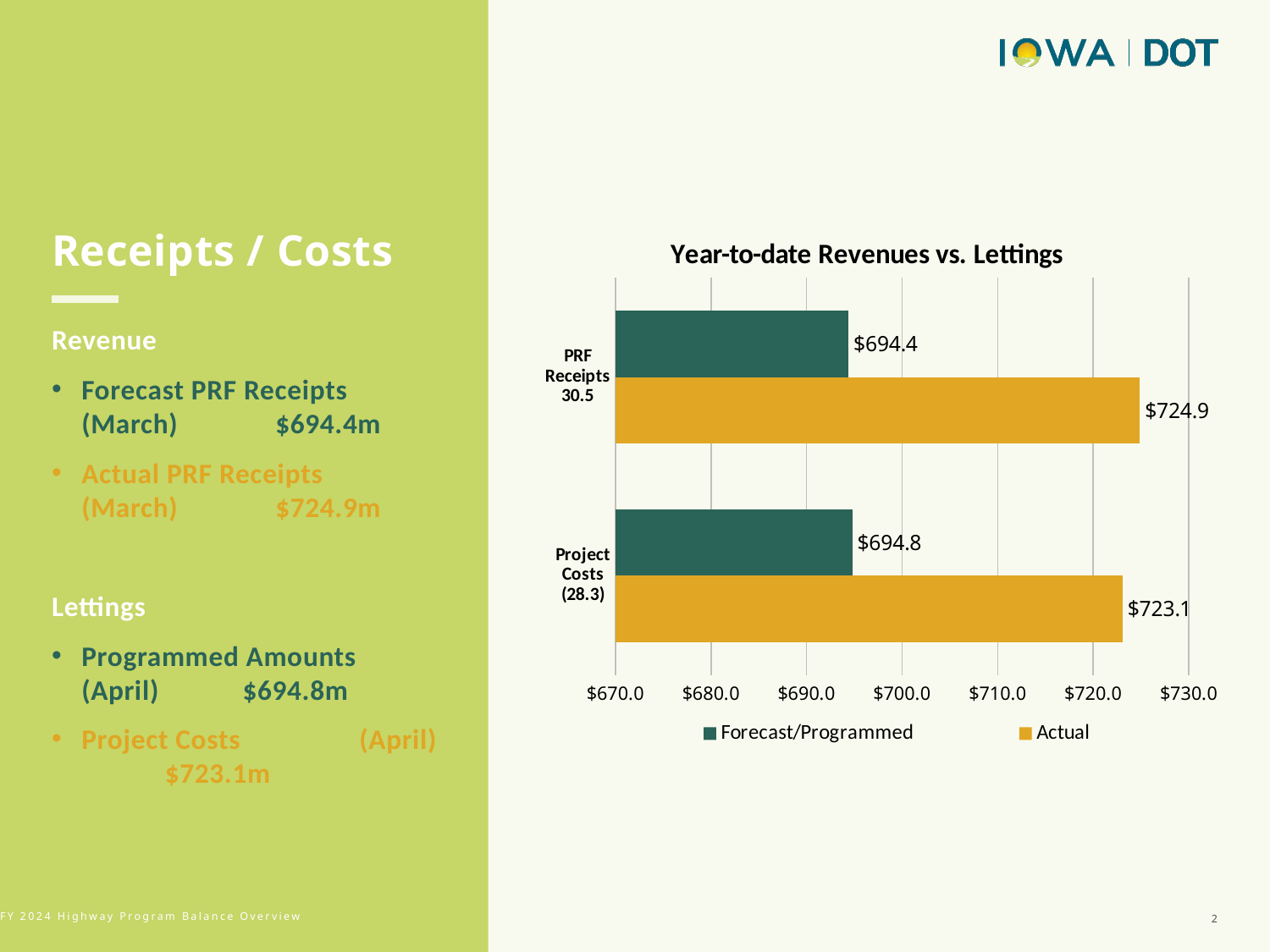
What is the Actual value for Project Costs? $723.1 What is the title of the chart? Year-to-date Revenues vs. Lettings Which is larger: the Actual value for PRF Receipts or the Actual value for Project Costs? Actual value for PRF Receipts What is the difference between the Actual and Forecast/Programmed values for Project Costs? $28.3 What is the Forecast/Programmed value for PRF Receipts? $694.4 Which bar in the chart has the lowest value? Forecast/Programmed PRF Receipts What kind of chart is shown on the slide? Bar chart How many series does the legend list? 2 Which bar in the chart has the highest value? Actual PRF Receipts What is the Forecast/Programmed value for Project Costs? $694.8 What is the difference between the Actual and Forecast/Programmed values for PRF Receipts? $30.5 What is the Actual value for PRF Receipts? $724.9